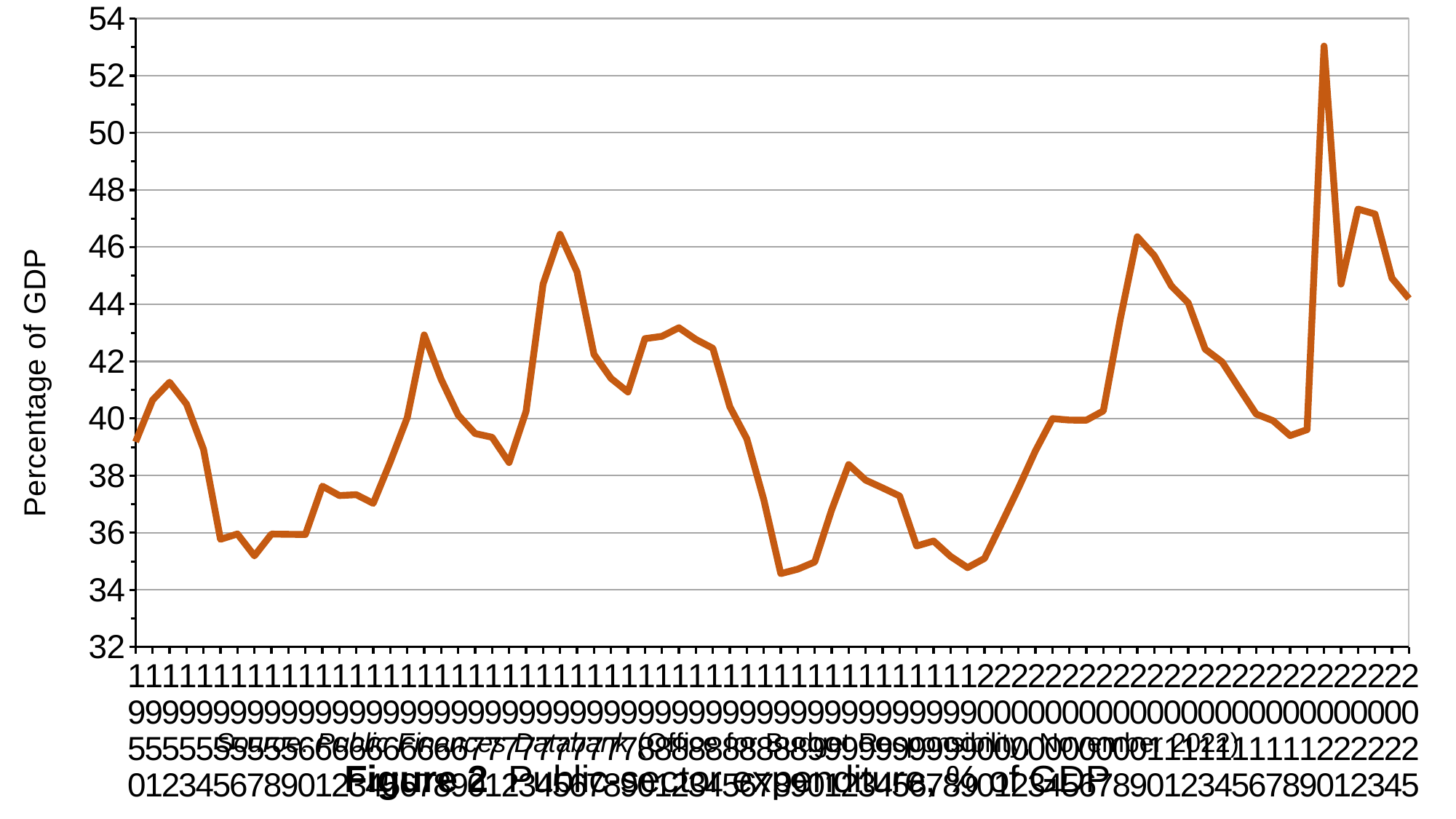
Between 2010 and 2019, does the line generally rise or fall? fall In which year does the line reach its highest value? 2020 Is the value for 1950 greater or less than 42? less What is the title of the chart (Figure 2)? Public sector expenditure, % of GDP Which year has the larger value, 2020 or 1975? 2020 What kind of chart is shown on the slide? line chart Is the value for 1975 greater or less than 44? greater Is the lowest value on the chart greater or less than 36? less What is the label on the vertical axis of the chart? Percentage of GDP What is the first year shown on the horizontal axis? 1950 Which year has the larger value, 1975 or 1950? 1975